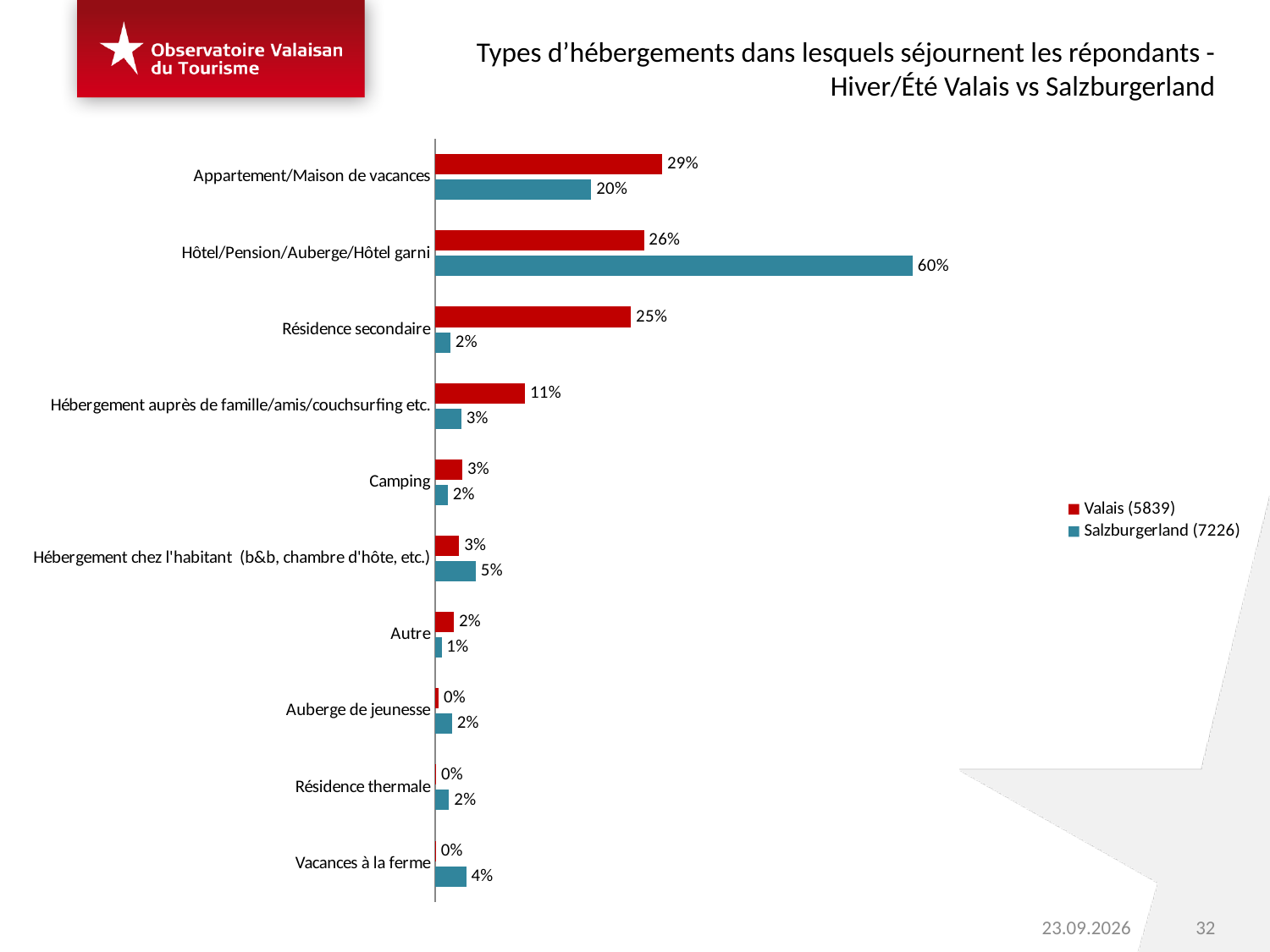
Which category has the highest value for Salzburgerland (7226)? Hôtel/Pension/Auberge/Hôtel garni What is the value for Valais (5839) for Hébergement auprès de famille/amis/couchsurfing etc.? 11% What is the difference between the Salzburgerland (7226) and Valais (5839) values for Hôtel/Pension/Auberge/Hôtel garni? 34% Which category has the highest value for Valais (5839)? Appartement/Maison de vacances How many series does the legend list? 2 What is the value for Salzburgerland (7226) for Résidence secondaire? 2% How many accommodation categories are shown in the chart? 10 For Hébergement chez l'habitant (b&b, chambre d'hôte, etc.), which series has the larger value? Salzburgerland (7226) What kind of chart is shown on the slide? Bar chart What is the value for Valais (5839) for Appartement/Maison de vacances? 29% What is the difference between the Valais (5839) and Salzburgerland (7226) values for Résidence secondaire? 23% What is the value for Salzburgerland (7226) for Hôtel/Pension/Auberge/Hôtel garni? 60%